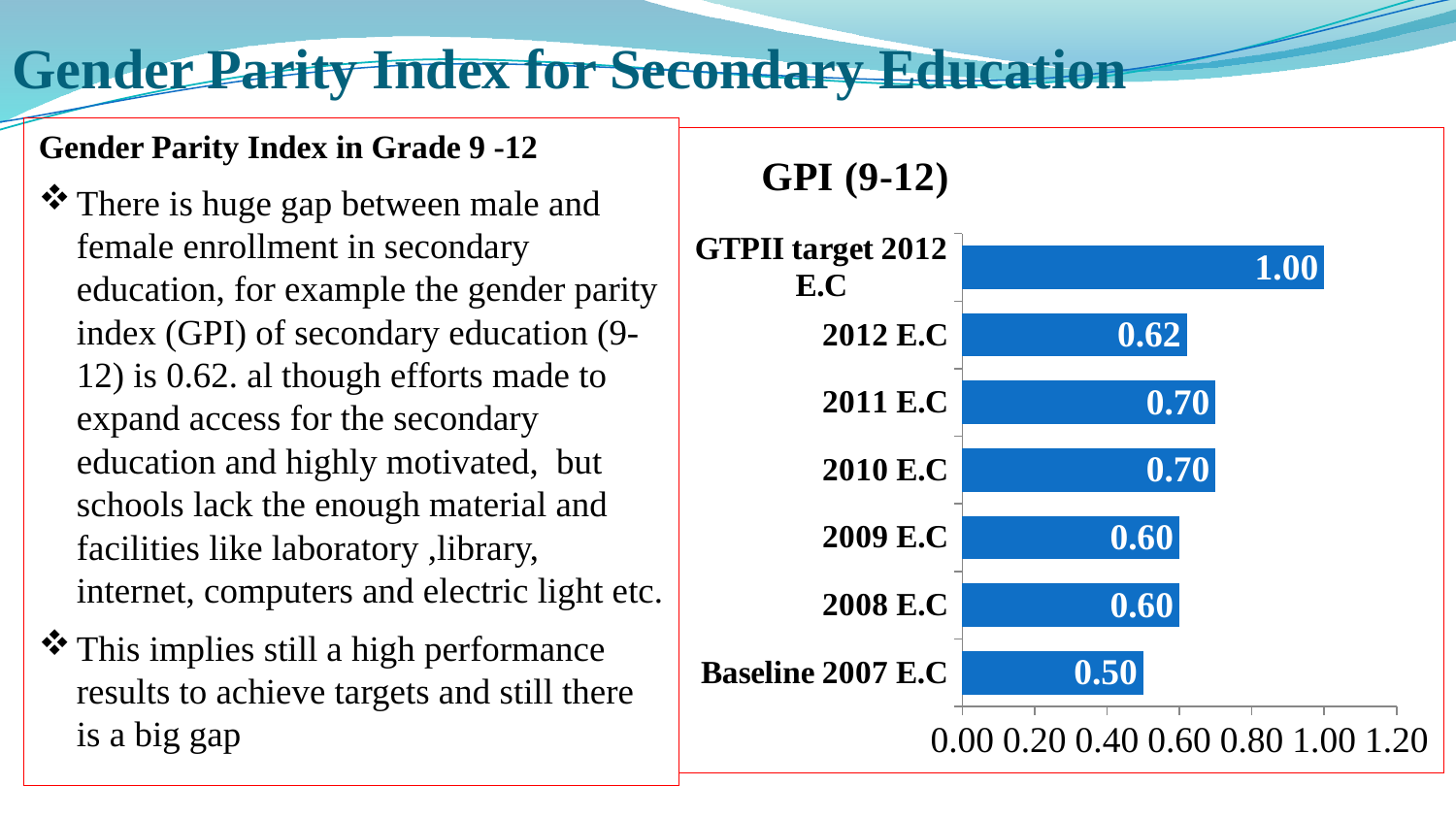
What is the GPI (9-12) value for the GTPII target 2012 E.C? 1.00 What is the GPI (9-12) value for 2010 E.C? 0.70 Which category has the lowest value in the GPI (9-12) chart? Baseline 2007 E.C Which is larger in the GPI (9-12) chart: the value for 2011 E.C or the value for 2012 E.C? 2011 E.C What is the GPI (9-12) value for 2012 E.C? 0.62 What is the difference between the GTPII target 2012 E.C value and the 2012 E.C value in the GPI (9-12) chart? 0.38 Which category has the highest value in the GPI (9-12) chart? GTPII target 2012 E.C What is the difference between the 2009 E.C value and the Baseline 2007 E.C value in the GPI (9-12) chart? 0.10 What is the GPI (9-12) value for Baseline 2007 E.C? 0.50 What is the title of the chart on the slide? GPI (9-12) How many categories are shown in the GPI (9-12) chart? 7 What kind of chart is the GPI (9-12) chart? Bar chart